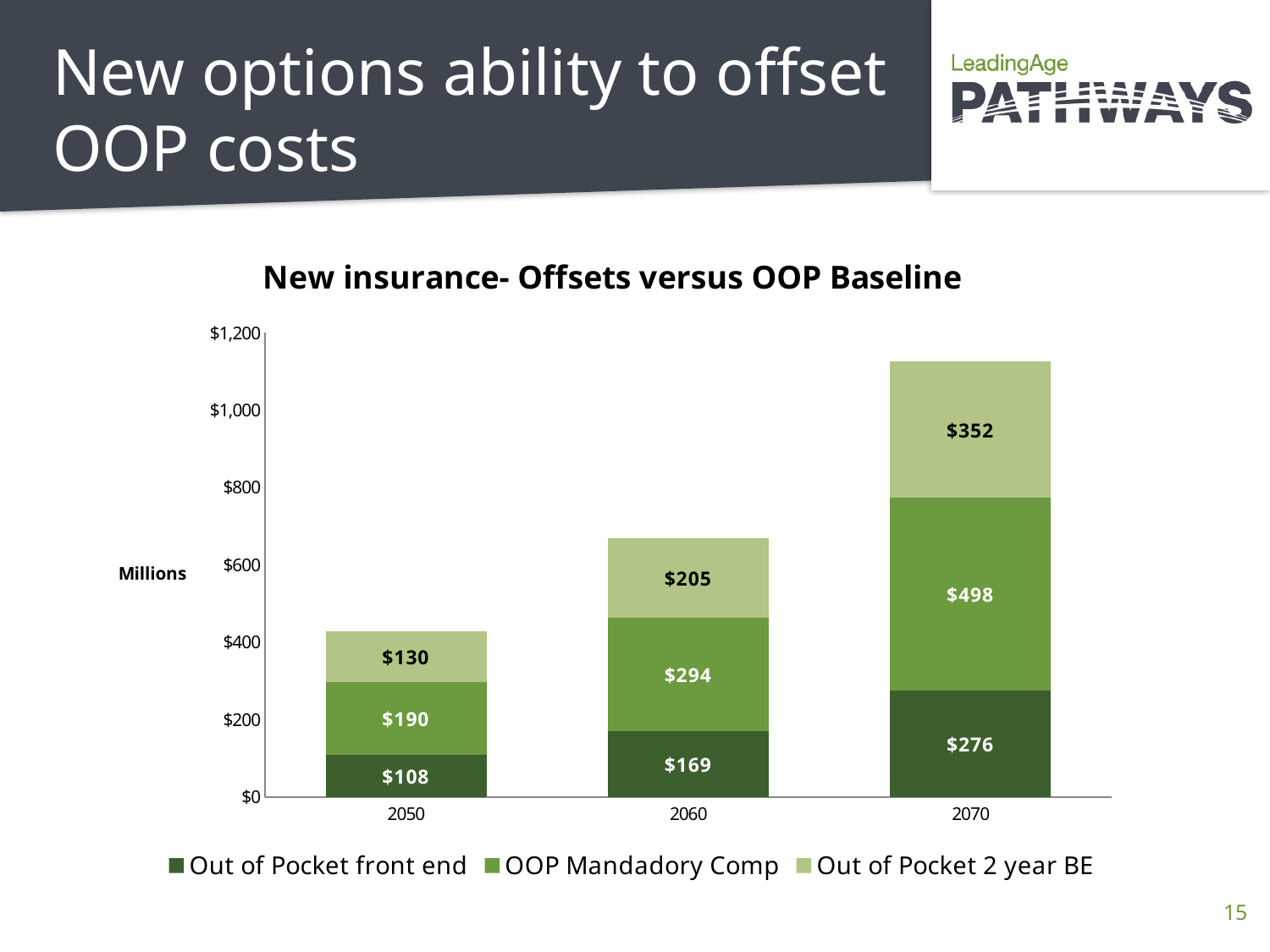
What is the value for Out of Pocket front end in 2050? $108 What is the value for OOP Mandadory Comp in 2060? $294 What kind of chart is shown? Stacked bar chart Which year has the highest value for OOP Mandadory Comp? 2070 How many years are shown on the x axis? 3 Which is larger: OOP Mandadory Comp in 2050 or Out of Pocket front end in 2060? OOP Mandadory Comp in 2050 How many series does the legend list? 3 What is the difference between the Out of Pocket 2 year BE values for 2070 and 2060? $147 What is the total of the stacked bar for 2060? $668 What is the value for Out of Pocket 2 year BE in 2070? $352 Which year has the lowest value for Out of Pocket front end? 2050 Is the total stacked bar for 2070 greater or less than $1,000? greater